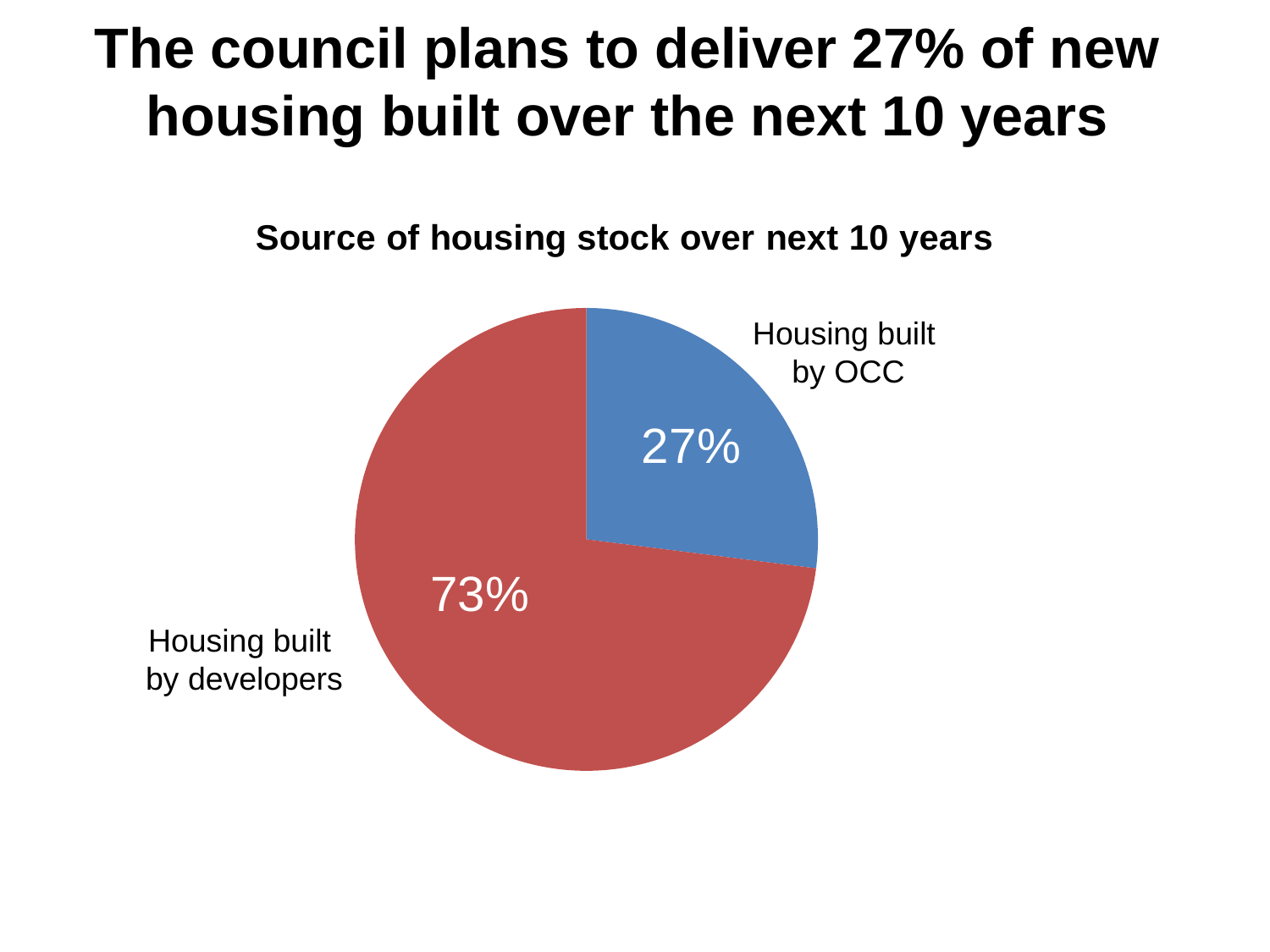
What is the title of the chart? Source of housing stock over next 10 years What kind of chart is shown on the slide? Pie chart Which is larger: the share of housing built by OCC or the share built by developers? Housing built by developers What do the two slices of the pie chart add up to? 100% What share of housing stock over the next 10 years is built by OCC? 27% Which source accounts for the smallest share of housing stock over the next 10 years? Housing built by OCC What share of housing stock over the next 10 years is built by developers? 73% Is the share of housing built by developers greater or less than 50%? greater Which source accounts for the largest share of housing stock over the next 10 years? Housing built by developers What colour is the slice for housing built by OCC? Blue What is the difference in percentage points between the share built by developers and the share built by OCC? 46 percentage points How many slices does the pie chart have? 2